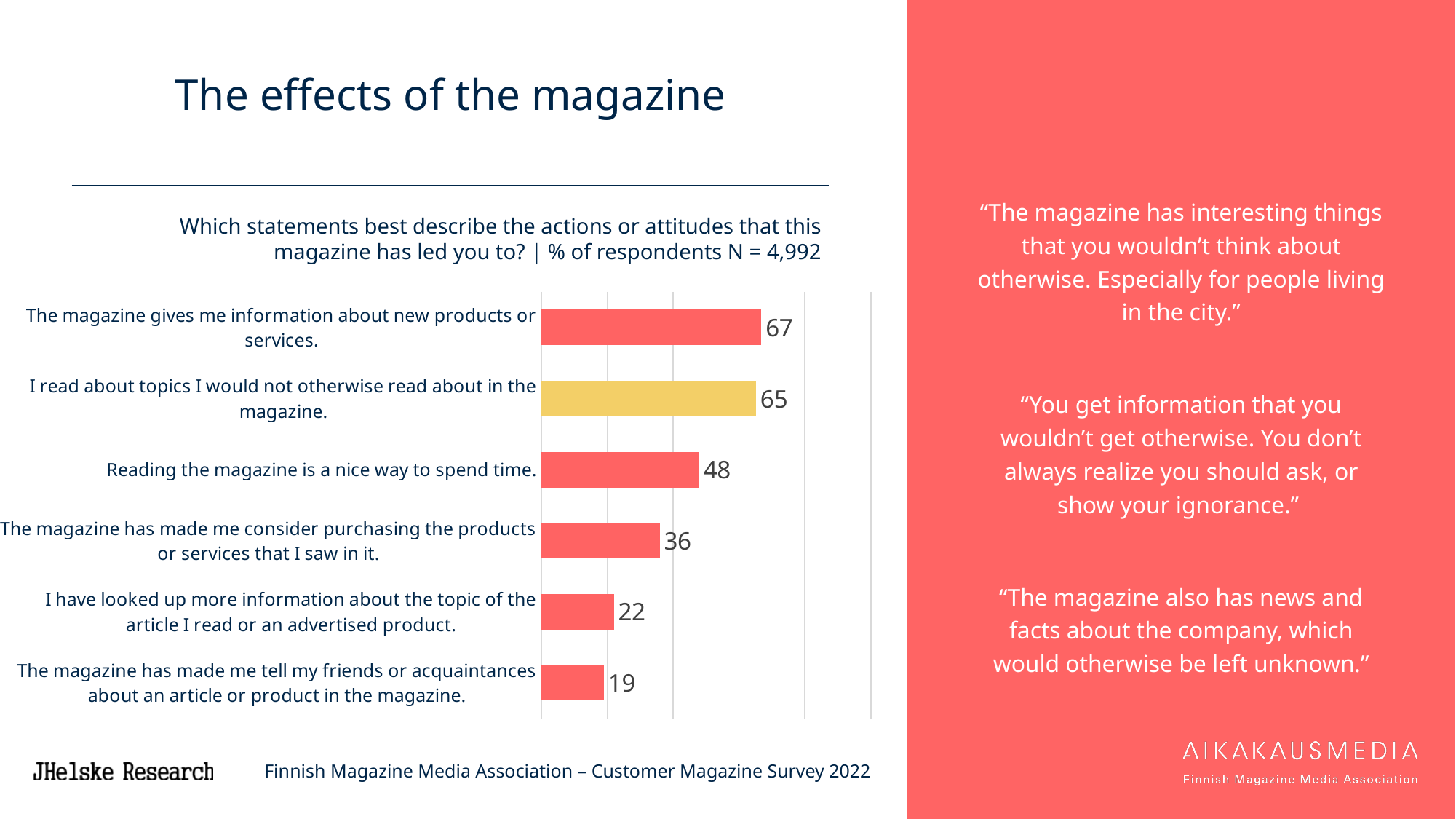
What is the difference between the highest and lowest values in the chart? 48 How many statements are shown in the chart? 6 What is the difference between the value for "I read about topics I would not otherwise read about in the magazine." and the value for "Reading the magazine is a nice way to spend time."? 17 What percentage of respondents said the magazine has made them tell friends or acquaintances about an article or product? 19 What is the value for "Reading the magazine is a nice way to spend time."? 48 Which is larger: the value for "The magazine has made me consider purchasing the products or services that I saw in it." or the value for "I have looked up more information about the topic of the article I read or an advertised product."? The magazine has made me consider purchasing the products or services that I saw in it. How many respondents (N) does the chart subtitle state? 4,992 Which statement has the highest percentage of respondents? The magazine gives me information about new products or services. What kind of chart is shown on the slide? Bar chart Which bar in the chart is coloured yellow rather than red? I read about topics I would not otherwise read about in the magazine. Which statement has the lowest percentage of respondents? The magazine has made me tell my friends or acquaintances about an article or product in the magazine. What percentage of respondents said the magazine gives them information about new products or services? 67